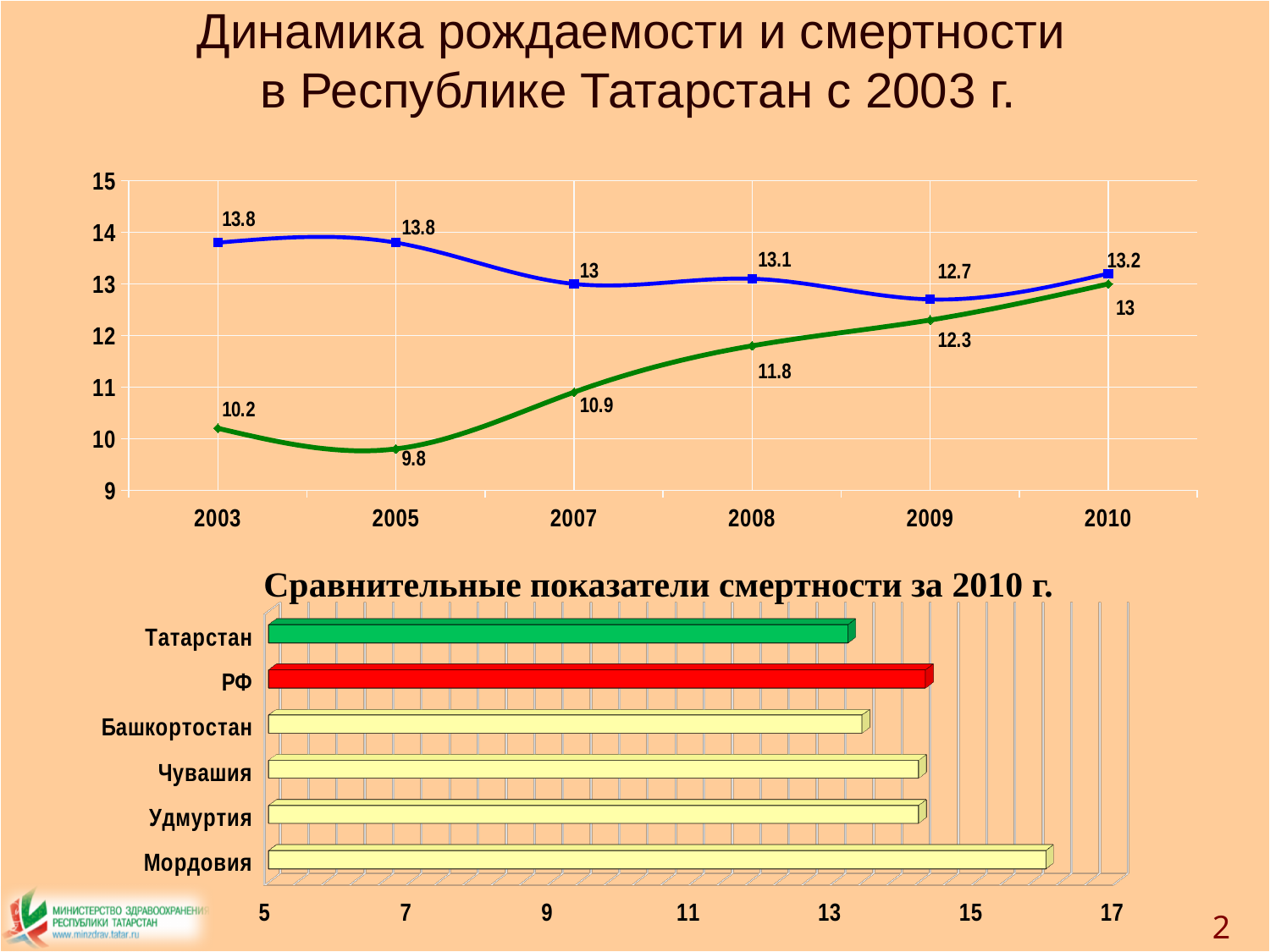
In the top chart, what is the difference between the blue line and the green line in 2003? 3.6 In the top chart, what is the value of the green line in 2010? 13 In the top chart, what is the value of the blue line in 2009? 12.7 In the bottom chart 'Сравнительные показатели смертности за 2010 г.', which region has the highest value? Мордовия In the top chart, in which year does the green line reach its lowest value? 2005 In the top chart, how many years are plotted on the x axis? 6 In the top chart, does the green line rise or fall from 2005 to 2010? rise In the top chart, what is the value of the blue line in 2003? 13.8 What kind of chart is the bottom chart 'Сравнительные показатели смертности за 2010 г.'? bar chart In the top chart, what is the value of the green line in 2005? 9.8 In the bottom chart 'Сравнительные показатели смертности за 2010 г.', is the value for Мордовия greater or less than 15? greater In the top chart, in which year does the blue line reach its lowest value? 2009